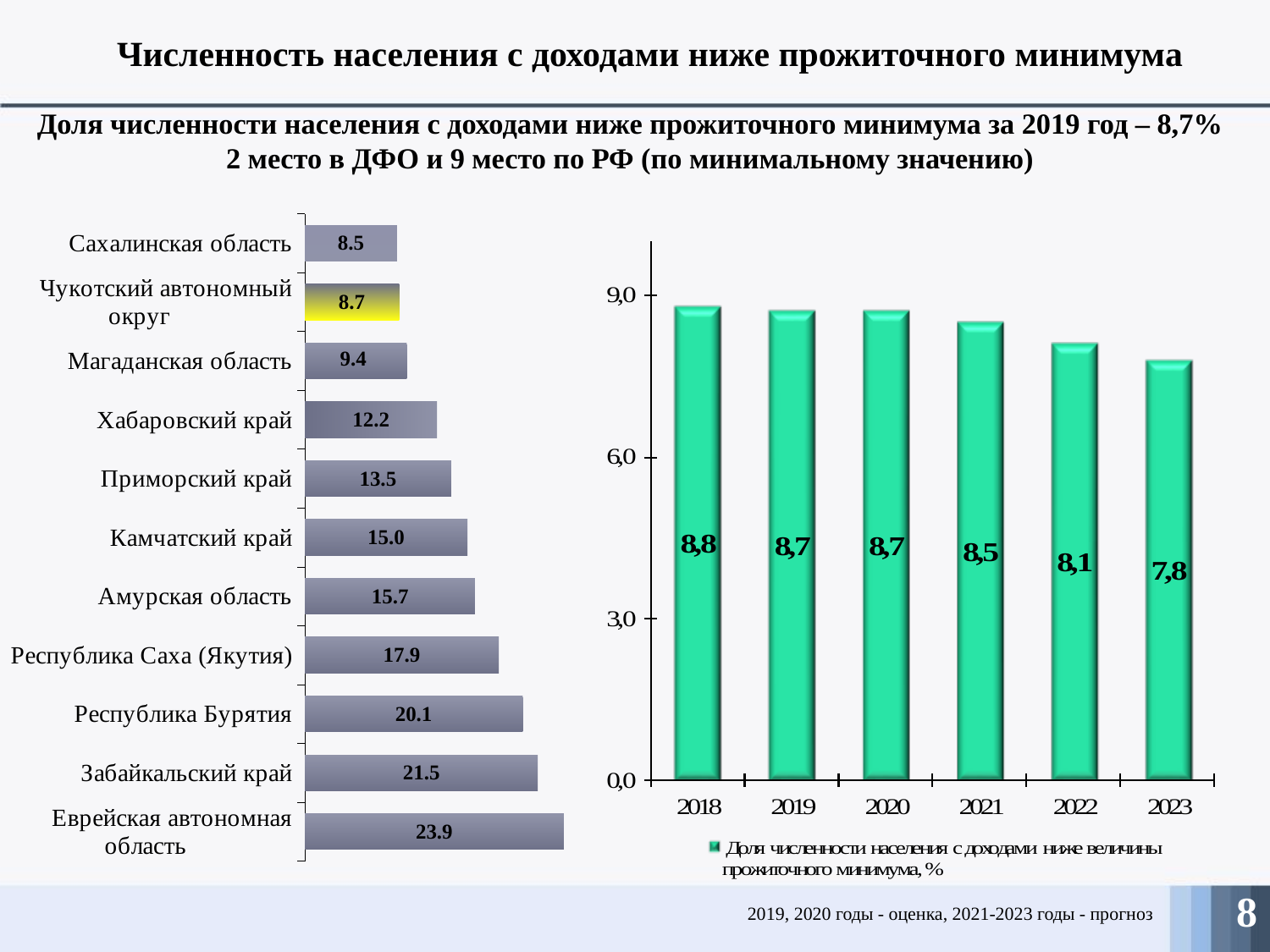
In the left chart, what is the difference between the values for Забайкальский край and Республика Бурятия? 1.4 In the right chart, what is the difference between the values for 2018 and 2023? 1,0 In the left chart, which is larger: the value for Камчатский край or Приморский край? Камчатский край In the left chart, which region has the lowest value? Сахалинская область How many regions are shown in the left chart? 11 In the left chart, what is the value for Хабаровский край? 12.2 In the right chart, what is the value for 2021? 8,5 What kind of chart is the right chart? bar chart In the left chart, which region has the highest value? Еврейская автономная область In the right chart, which year has the lowest value? 2023 In the right chart, do the values rise or fall from 2018 to 2023? fall In the left chart, what is the value for Республика Саха (Якутия)? 17.9